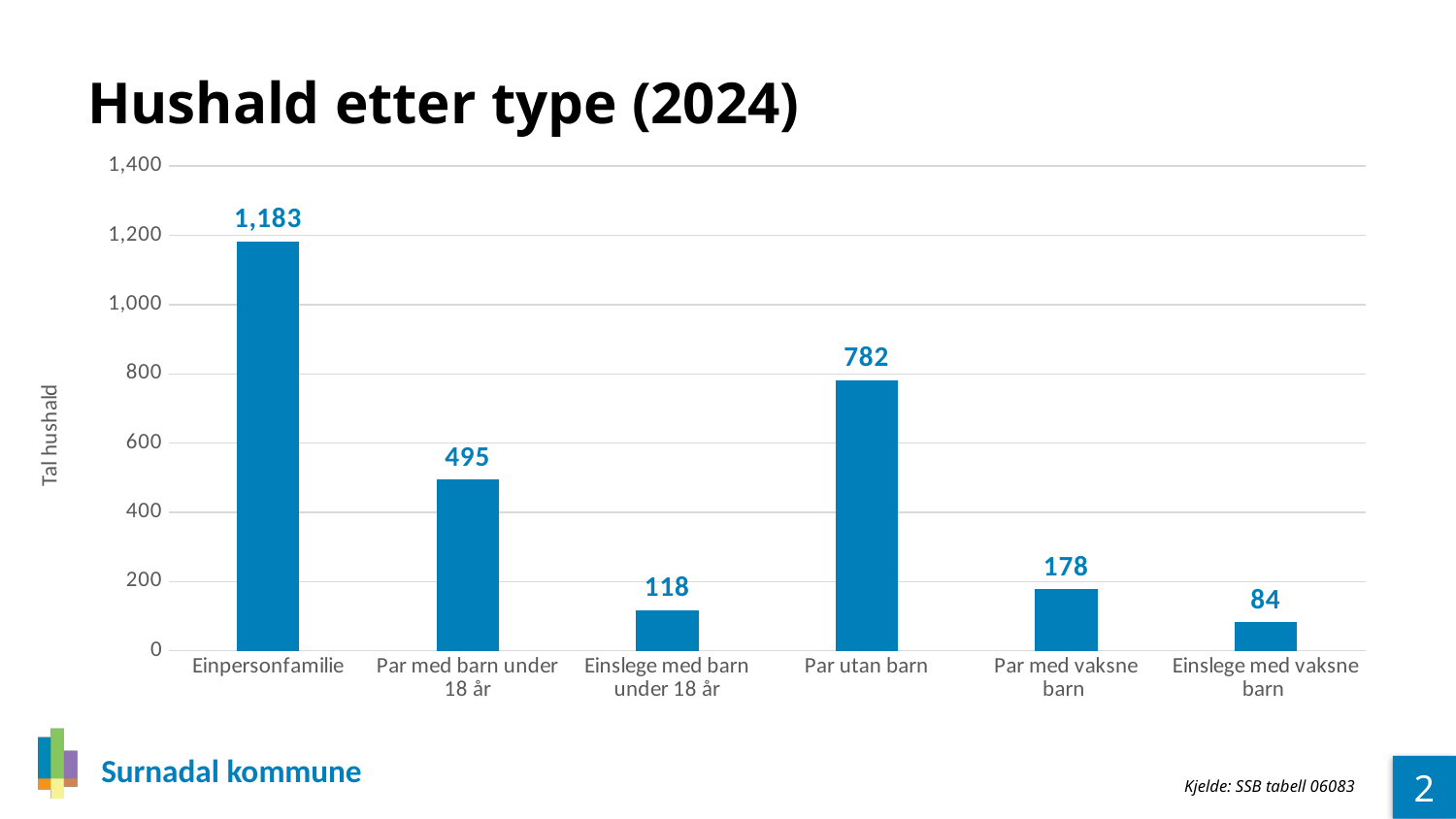
What is the title of the chart? Hushald etter type (2024) Which household type has the highest value? Einpersonfamilie What is the value for Par utan barn? 782 Is the value for Par utan barn greater or less than 600? greater Which household type has the lowest value? Einslege med vaksne barn What is the difference between Par med barn under 18 år and Par med vaksne barn? 317 Which is larger, Par med barn under 18 år or Einslege med barn under 18 år? Par med barn under 18 år What kind of chart is shown on the slide? bar chart What is the value for Einpersonfamilie? 1,183 What is the difference between Einpersonfamilie and Par utan barn? 401 What is the value for Einslege med vaksne barn? 84 How many household types are shown on the chart? 6